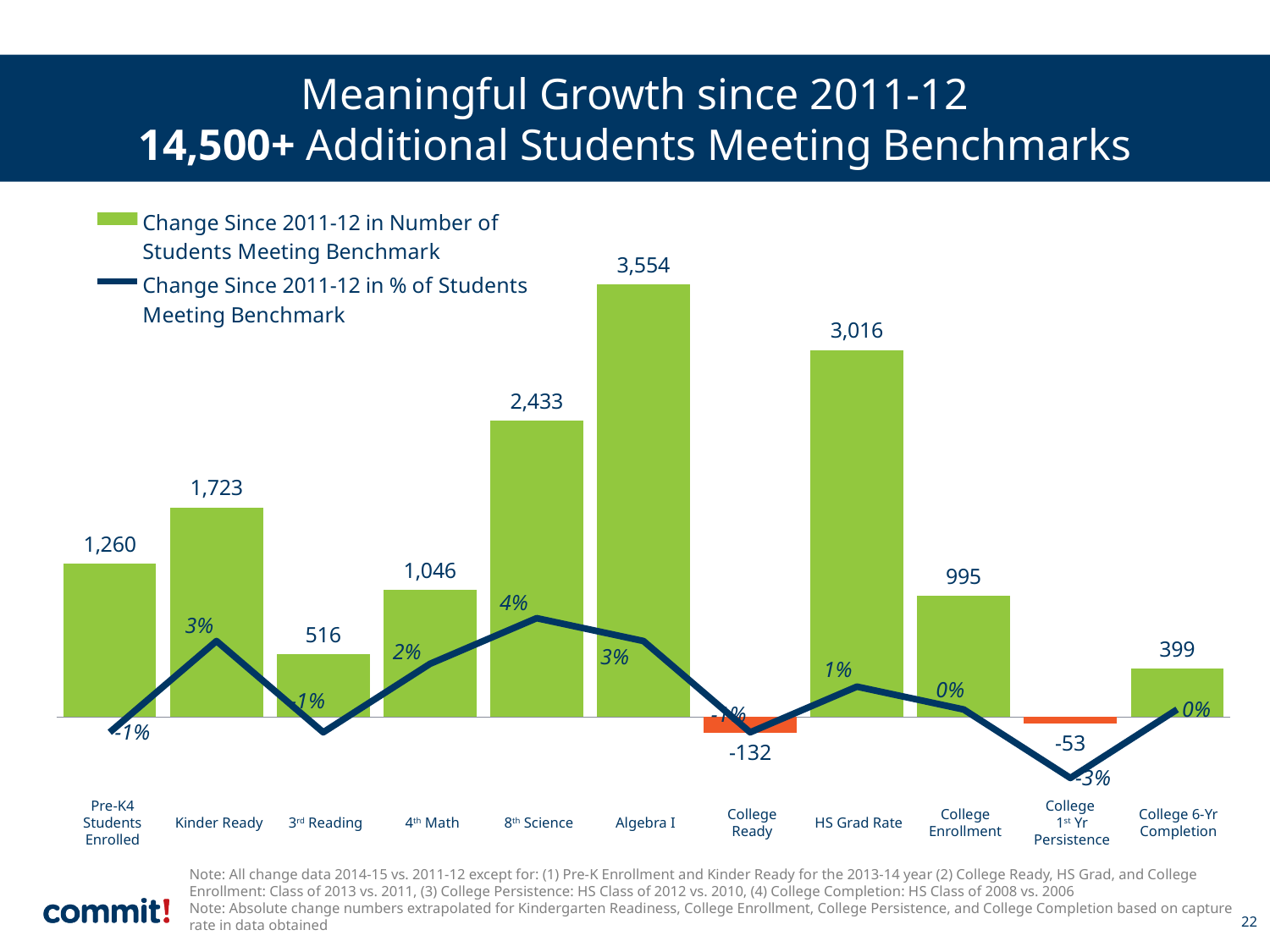
What is the change since 2011-12 in number of students meeting benchmark for Algebra I? 3,554 How many series does the chart legend list? 2 Which category has the lowest change in number of students meeting benchmark? College Ready What is the difference between the change in number of students for Kinder Ready and for Pre-K4 Students Enrolled? 463 Which category has the highest change in number of students meeting benchmark? Algebra I What is the change since 2011-12 in % of students meeting benchmark for 8th Science? 4% Which has a larger change in number of students meeting benchmark, 4th Math or College Enrollment? 4th Math Which category has the highest change in % of students meeting benchmark? 8th Science What is the difference between the change in number of students for Algebra I and for HS Grad Rate? 538 What kind of chart is shown on the slide? Bar chart with a line series How many categories are shown on the x axis of the chart? 11 What is the change in number of students meeting benchmark for College 1st Yr Persistence? -53